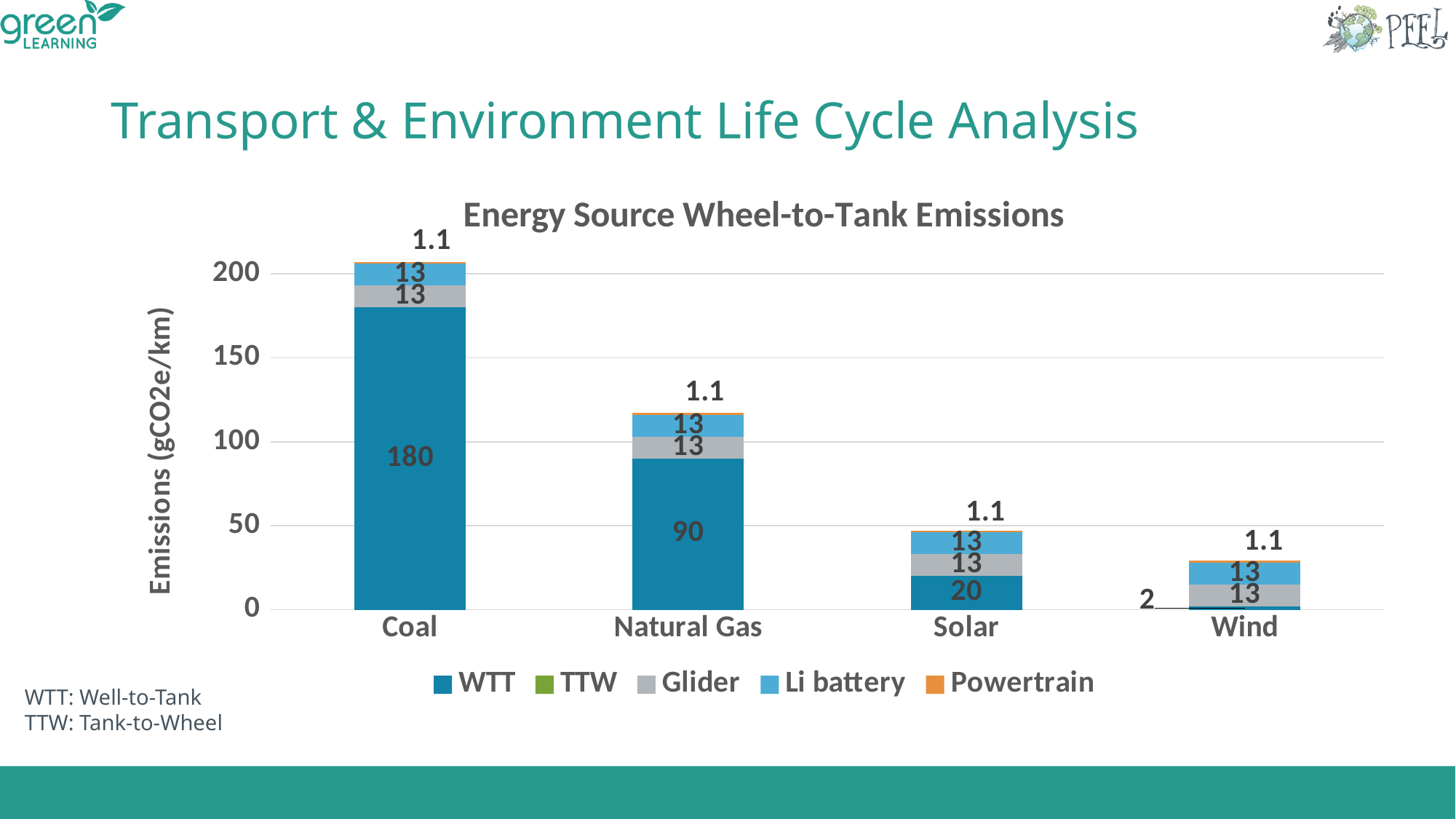
How many series does the legend list? 5 What is the WTT value for Natural Gas? 90 What type of chart is shown? Stacked bar chart Which has a larger WTT value, Solar or Natural Gas? Natural Gas What is the difference between the WTT values for Coal and Natural Gas? 90 How many energy sources are shown on the x axis? 4 What is the WTT value for Wind? 2 Which energy source has the lowest WTT emissions? Wind Is the total height of the Natural Gas bar greater or less than 100? greater Which energy source has the highest WTT emissions? Coal What is the Powertrain value for Solar? 1.1 What is the WTT value for Coal? 180